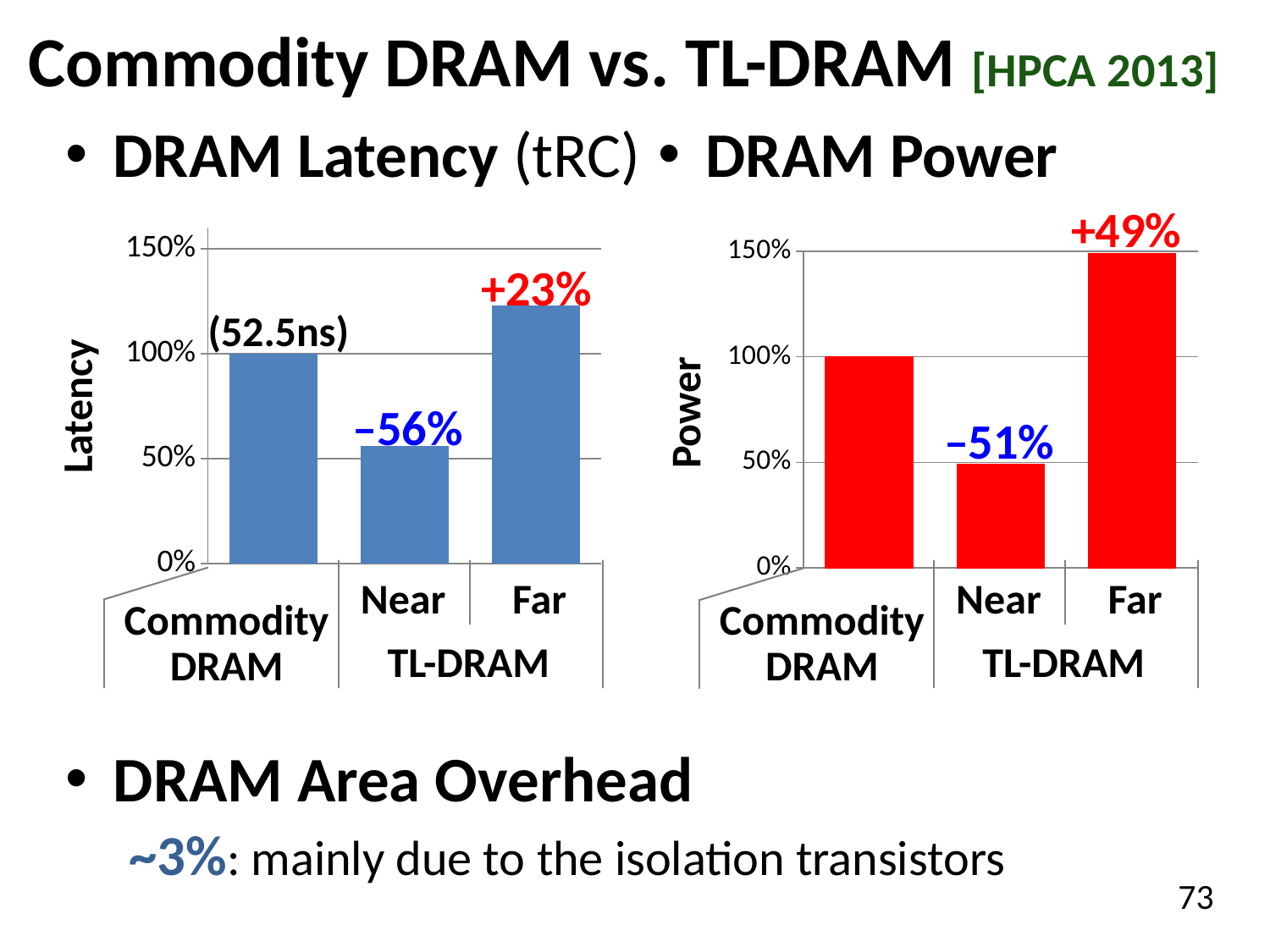
How many bars are plotted in the DRAM Latency chart? 3 In the DRAM Power chart, is the value for Far greater or less than 100%? greater In the DRAM Power chart, what label is shown above the Far bar? +49% In the DRAM Power chart, what label is shown above the Near bar? –51% In the DRAM Power chart, which bar is the lowest? Near In the DRAM Latency chart, what label is shown above the Far bar? +23% In the DRAM Latency chart, is the value for Near greater or less than 50%? greater What type of chart is the DRAM Power chart? bar chart In the DRAM Latency chart, what label is shown above the Near bar? –56% In the DRAM Power chart, which is larger, the Commodity DRAM bar or the Near bar? Commodity DRAM In the DRAM Latency chart, what absolute latency is noted for Commodity DRAM? 52.5ns In the DRAM Latency chart, which bar is the highest? Far